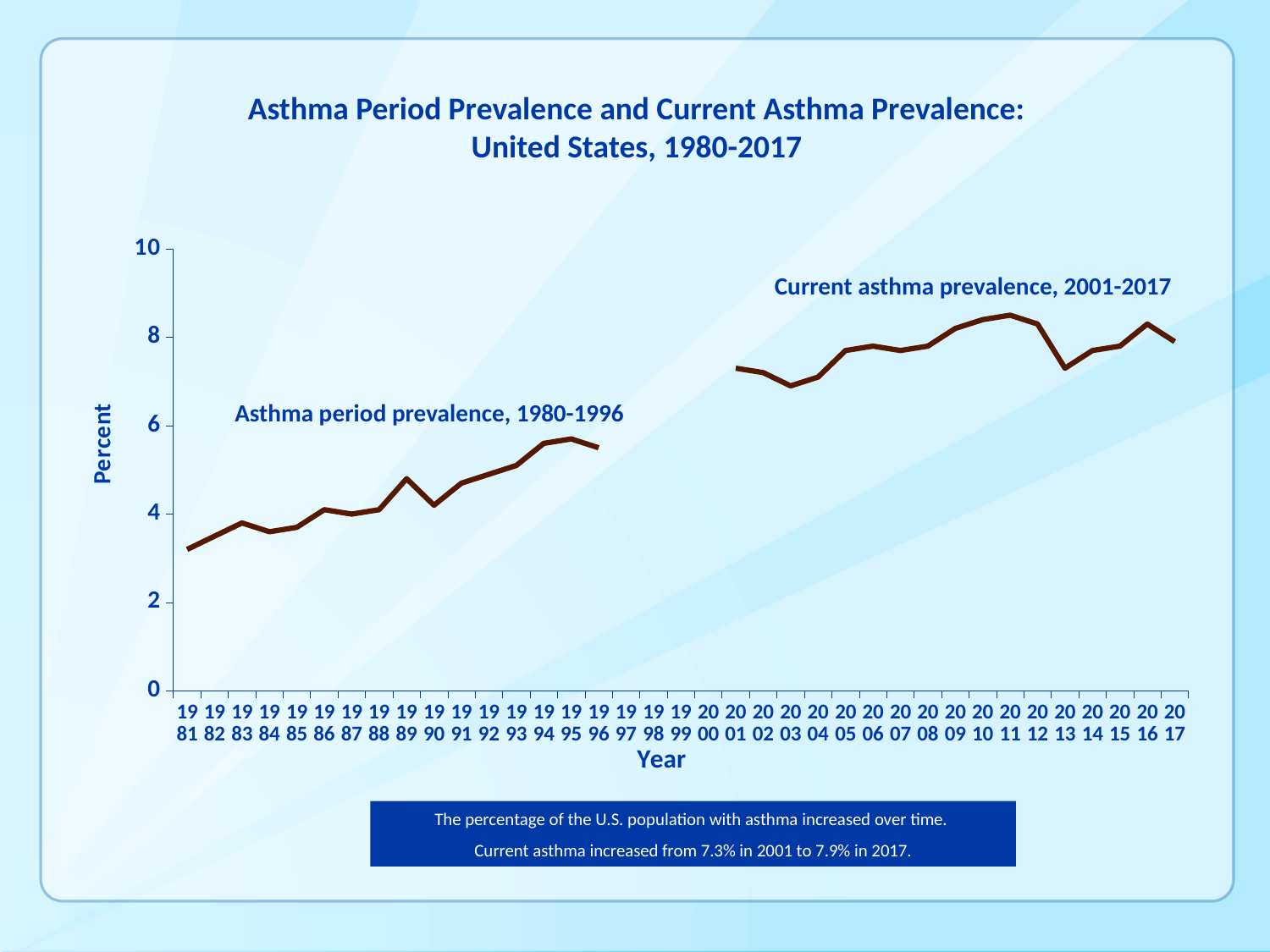
What was the current asthma prevalence in 2001? 7.3% How many data series are plotted on the chart? 2 By how many percentage points did current asthma prevalence increase from 2001 to 2017? 0.6 Which is larger: the current asthma prevalence in 2011 or in 2003? 2011 Is the current asthma prevalence value for 2003 greater or less than 8? less Which year has the lowest asthma period prevalence in the 1980-1996 series? 1981 What was the current asthma prevalence in 2017? 7.9% What is the label on the vertical axis of the chart? Percent Does the asthma period prevalence generally rise or fall from 1981 to 1996? rise What kind of chart is shown on the slide? line chart Is the current asthma prevalence value for 2011 greater or less than 8? greater Is the asthma period prevalence value for 1981 greater or less than 4? less